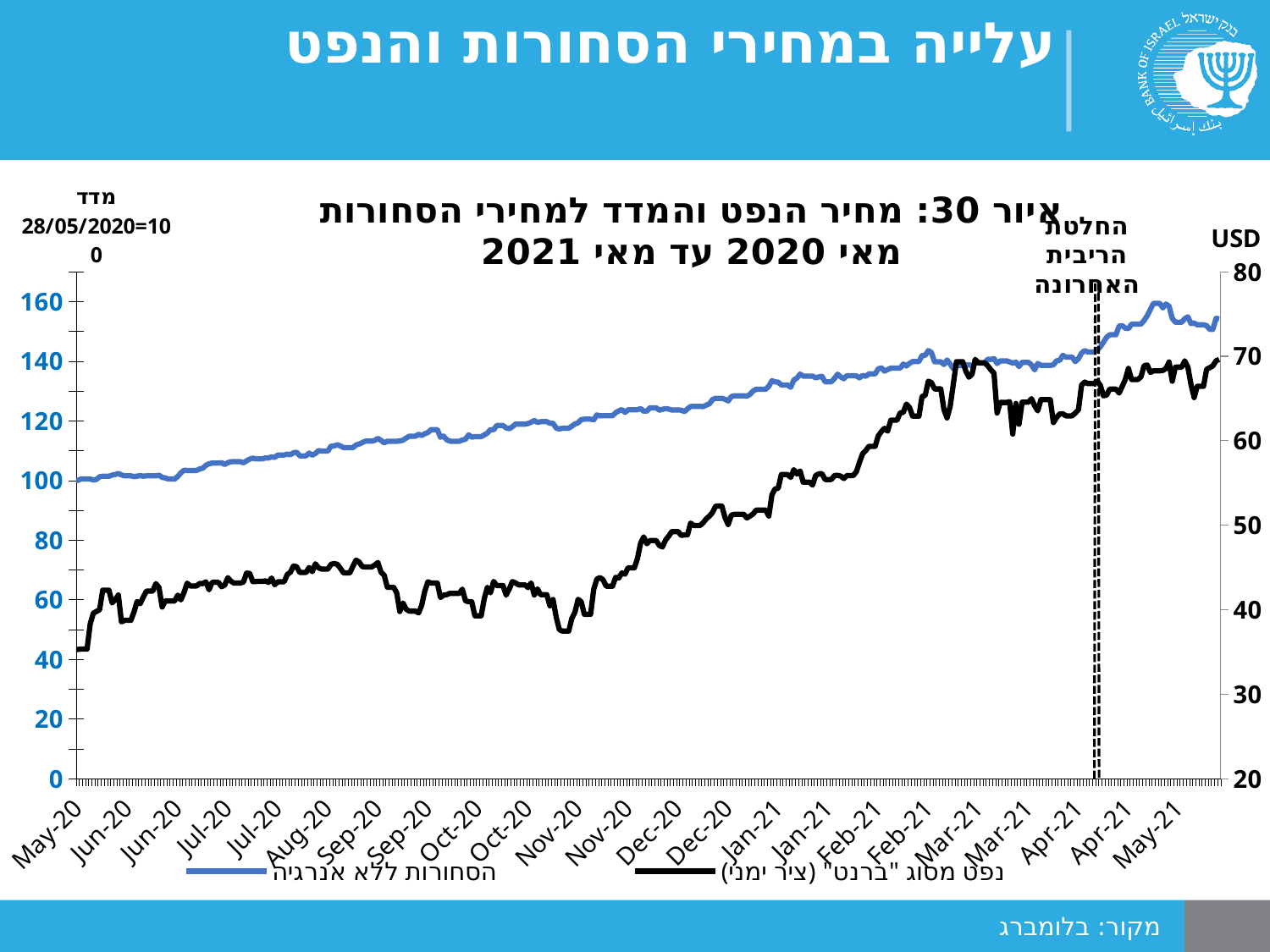
Does the Brent oil price (black line) rise or fall overall from May 2020 to May 2021? rise Does the commodities index excluding energy (blue line) rise or fall overall from May 2020 to May 2021? rise Is the Brent oil price (black line, right axis) in Feb-21 greater or less than 50 USD? greater Is the commodities index excluding energy (blue line) in Nov-20 greater or less than 100? greater How many series does the legend list? 2 What is the source cited at the bottom of the slide? בלומברג Is the commodities index excluding energy (blue line) at the end of the period (May-21) greater or less than 140? greater What kind of chart is shown on the slide? line chart What is the base value of the commodities index according to the left axis label? 28/05/2020=100